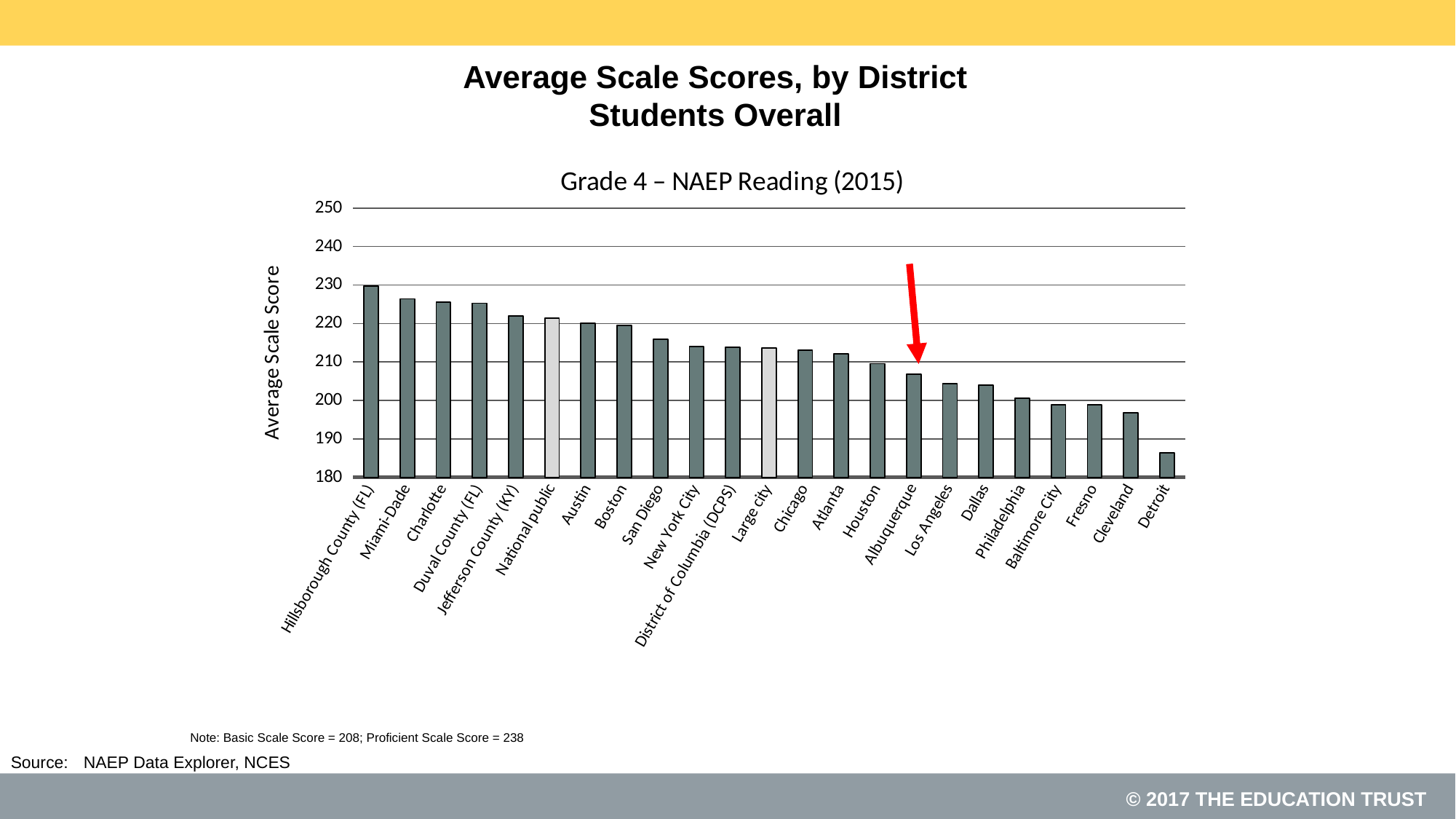
Is the value for Detroit greater or less than 190? less Do the values rise or fall moving from left to right along the x axis? Fall Which district has the lowest average scale score? Detroit Is the value for Cleveland greater or less than 200? less How many categories are plotted on the x axis? 23 Which district has the highest average scale score? Hillsborough County (FL) Is the value for Albuquerque greater or less than 210? less What is the label on the vertical axis of the chart? Average Scale Score Which has a higher average scale score, Boston or Dallas? Boston What kind of chart is shown on the slide? Bar chart